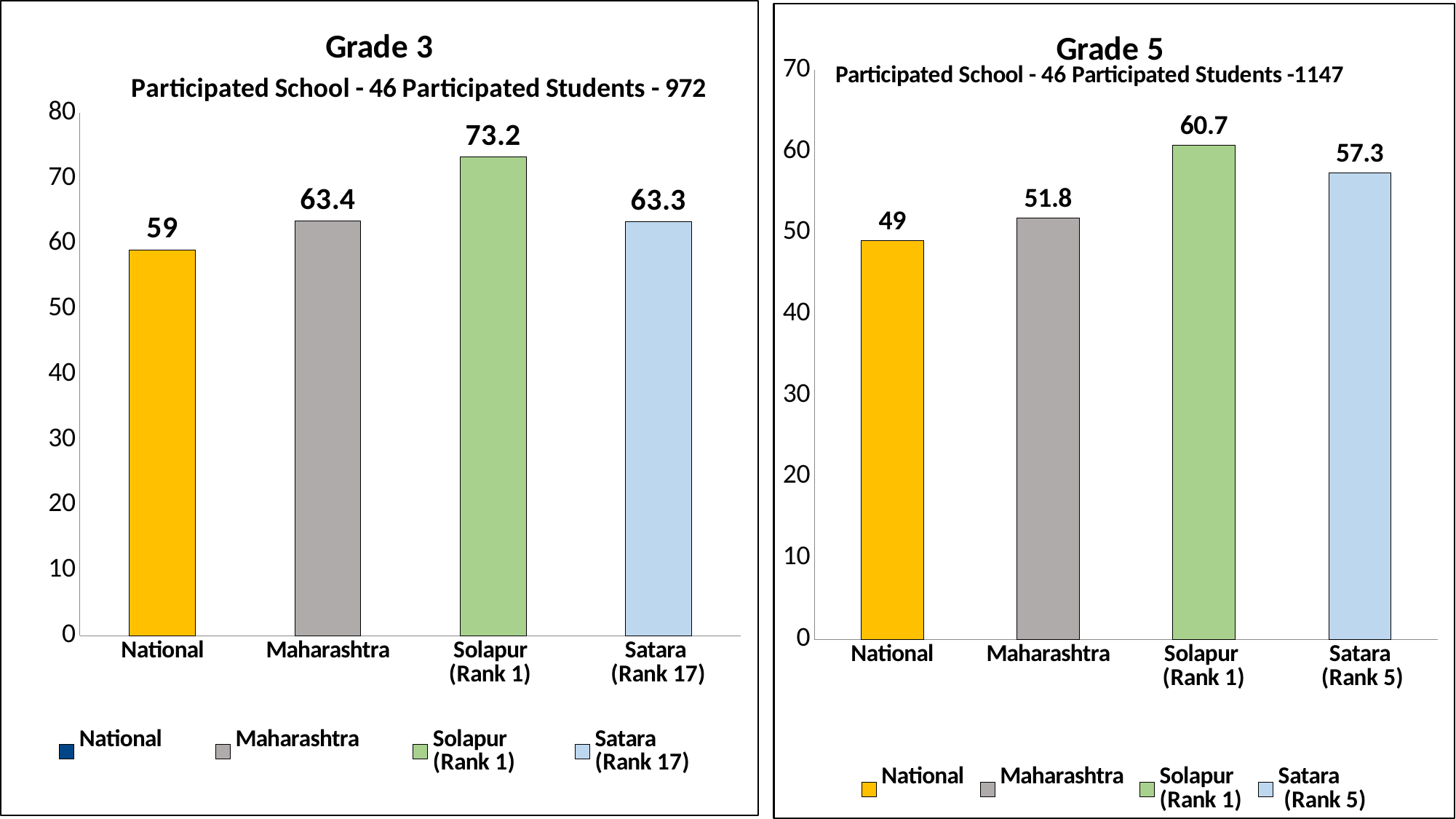
In the Grade 3 chart, which category has the lowest value? National In the Grade 5 chart, what is the difference between Solapur (Rank 1) and National? 11.7 In the Grade 5 chart, which is larger, Satara (Rank 5) or Maharashtra? Satara (Rank 5) How many categories are shown in the Grade 5 chart? 4 In the Grade 5 chart, what is the value for Maharashtra? 51.8 In the Grade 3 chart, what is the difference between Solapur (Rank 1) and Maharashtra? 9.8 What kind of chart is the Grade 3 chart? Bar chart In the Grade 3 chart, what is the value for National? 59 In the Grade 5 chart, which category has the highest value? Solapur (Rank 1) In the Grade 3 chart, what is the value for Solapur (Rank 1)? 73.2 In the Grade 3 chart, is the value for Satara (Rank 17) greater or less than 60? greater How many entries does the legend of the Grade 5 chart list? 4